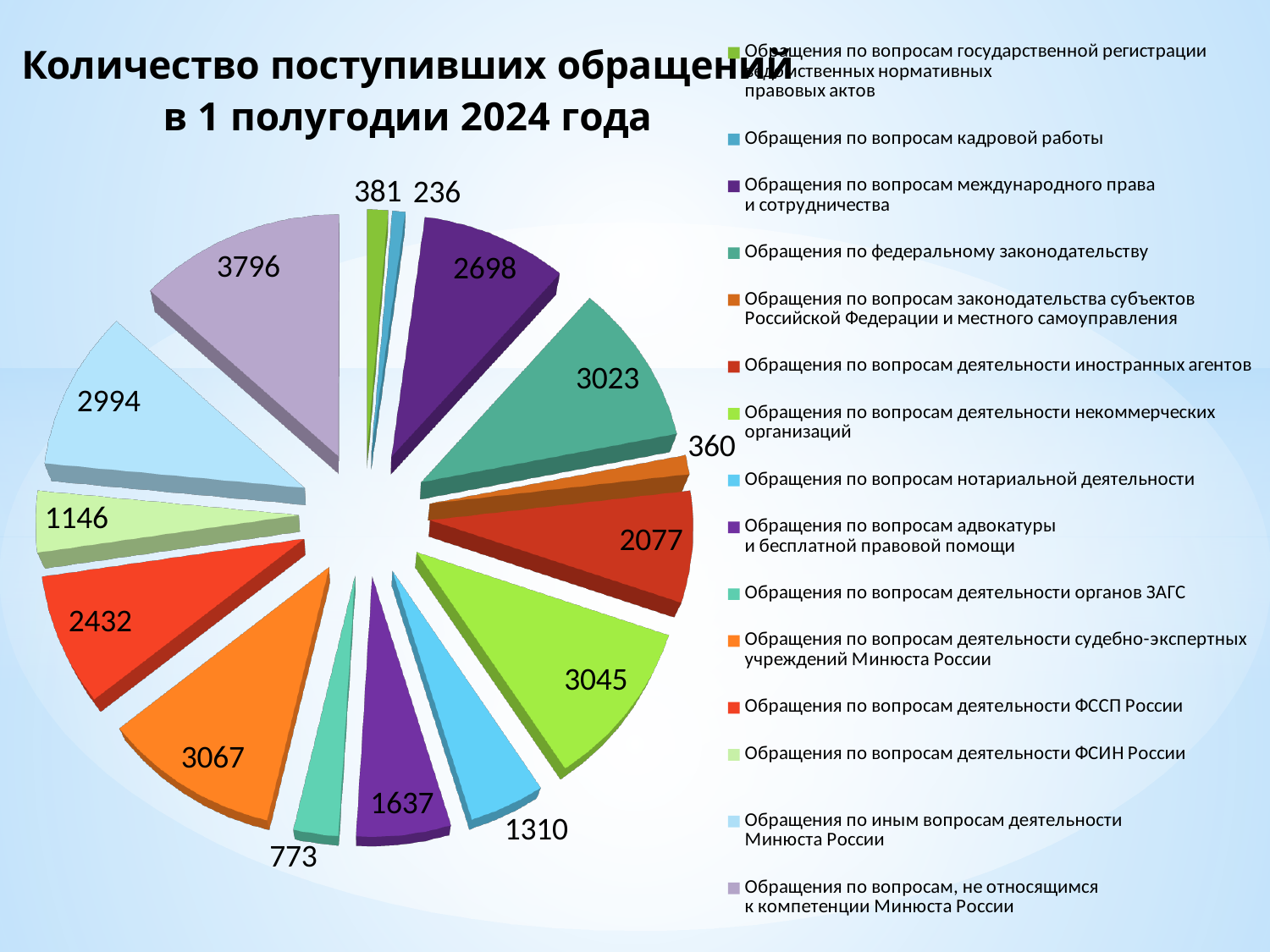
How many slices does the pie chart have? 15 What is the difference between the values for 'Обращения по вопросам деятельности судебно-экспертных учреждений Минюста России' and 'Обращения по вопросам деятельности ФССП России'? 635 Which is larger: the value for 'Обращения по вопросам международного права и сотрудничества' or the value for 'Обращения по вопросам деятельности иностранных агентов'? Обращения по вопросам международного права и сотрудничества What is the difference between the largest and smallest values in the pie chart? 3560 What is the value for 'Обращения по вопросам деятельности органов ЗАГС'? 773 Which category has the largest slice in the pie chart? Обращения по вопросам, не относящимся к компетенции Минюста России What is the value for 'Обращения по вопросам деятельности ФССП России'? 2432 Which category has the smallest slice in the pie chart? Обращения по вопросам кадровой работы What is the value for 'Обращения по вопросам нотариальной деятельности'? 1310 What kind of chart is shown on the slide? Pie chart What is the value for 'Обращения по федеральному законодательству'? 3023 What is the title of the chart? Количество поступивших обращений в 1 полугодии 2024 года